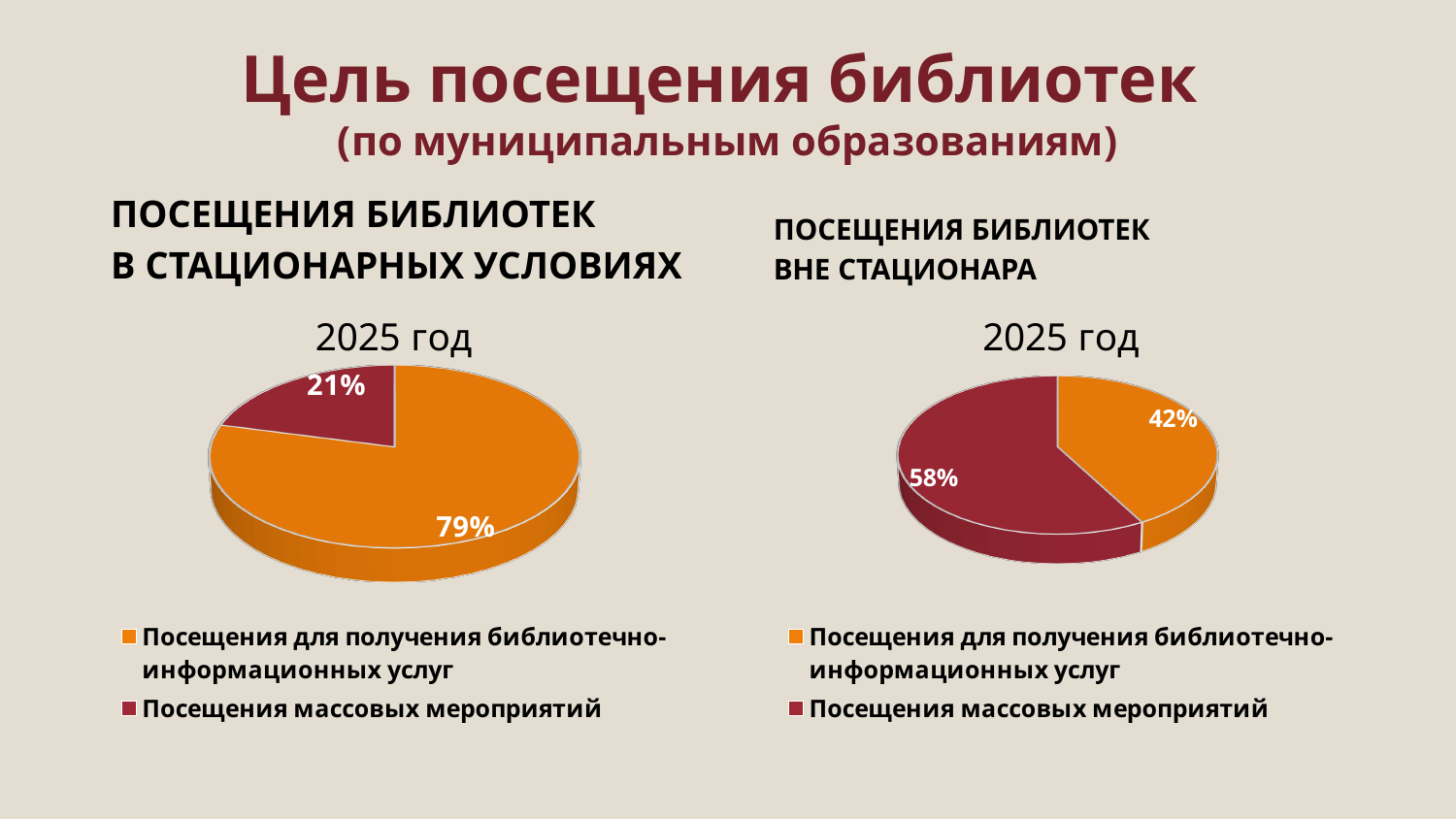
In the right chart (ПОСЕЩЕНИЯ БИБЛИОТЕК ВНЕ СТАЦИОНАРА), what share is shown for 'Посещения массовых мероприятий'? 58% In the left chart (ПОСЕЩЕНИЯ БИБЛИОТЕК В СТАЦИОНАРНЫХ УСЛОВИЯХ), what is the difference in percentage points between the two slices? 58 Which chart shows a larger share for 'Посещения массовых мероприятий': the left chart (В СТАЦИОНАРНЫХ УСЛОВИЯХ) or the right chart (ВНЕ СТАЦИОНАРА)? the right chart (ВНЕ СТАЦИОНАРА) In the left chart (ПОСЕЩЕНИЯ БИБЛИОТЕК В СТАЦИОНАРНЫХ УСЛОВИЯХ), what share is shown for 'Посещения массовых мероприятий'? 21% In the left chart (ПОСЕЩЕНИЯ БИБЛИОТЕК В СТАЦИОНАРНЫХ УСЛОВИЯХ), which category has the largest slice? Посещения для получения библиотечно-информационных услуг In the right chart (ПОСЕЩЕНИЯ БИБЛИОТЕК ВНЕ СТАЦИОНАРА), what share is shown for 'Посещения для получения библиотечно-информационных услуг'? 42% What type of chart is used on this slide? pie chart What year is shown in the title of the right chart (ПОСЕЩЕНИЯ БИБЛИОТЕК ВНЕ СТАЦИОНАРА)? 2025 год In the right chart (ПОСЕЩЕНИЯ БИБЛИОТЕК ВНЕ СТАЦИОНАРА), which category has the smallest slice? Посещения для получения библиотечно-информационных услуг How many categories does the legend of the left chart (ПОСЕЩЕНИЯ БИБЛИОТЕК В СТАЦИОНАРНЫХ УСЛОВИЯХ) list? 2 In the right chart (ПОСЕЩЕНИЯ БИБЛИОТЕК ВНЕ СТАЦИОНАРА), what is the difference in percentage points between 'Посещения массовых мероприятий' and 'Посещения для получения библиотечно-информационных услуг'? 16 In the left chart (ПОСЕЩЕНИЯ БИБЛИОТЕК В СТАЦИОНАРНЫХ УСЛОВИЯХ), what share is shown for 'Посещения для получения библиотечно-информационных услуг'? 79%